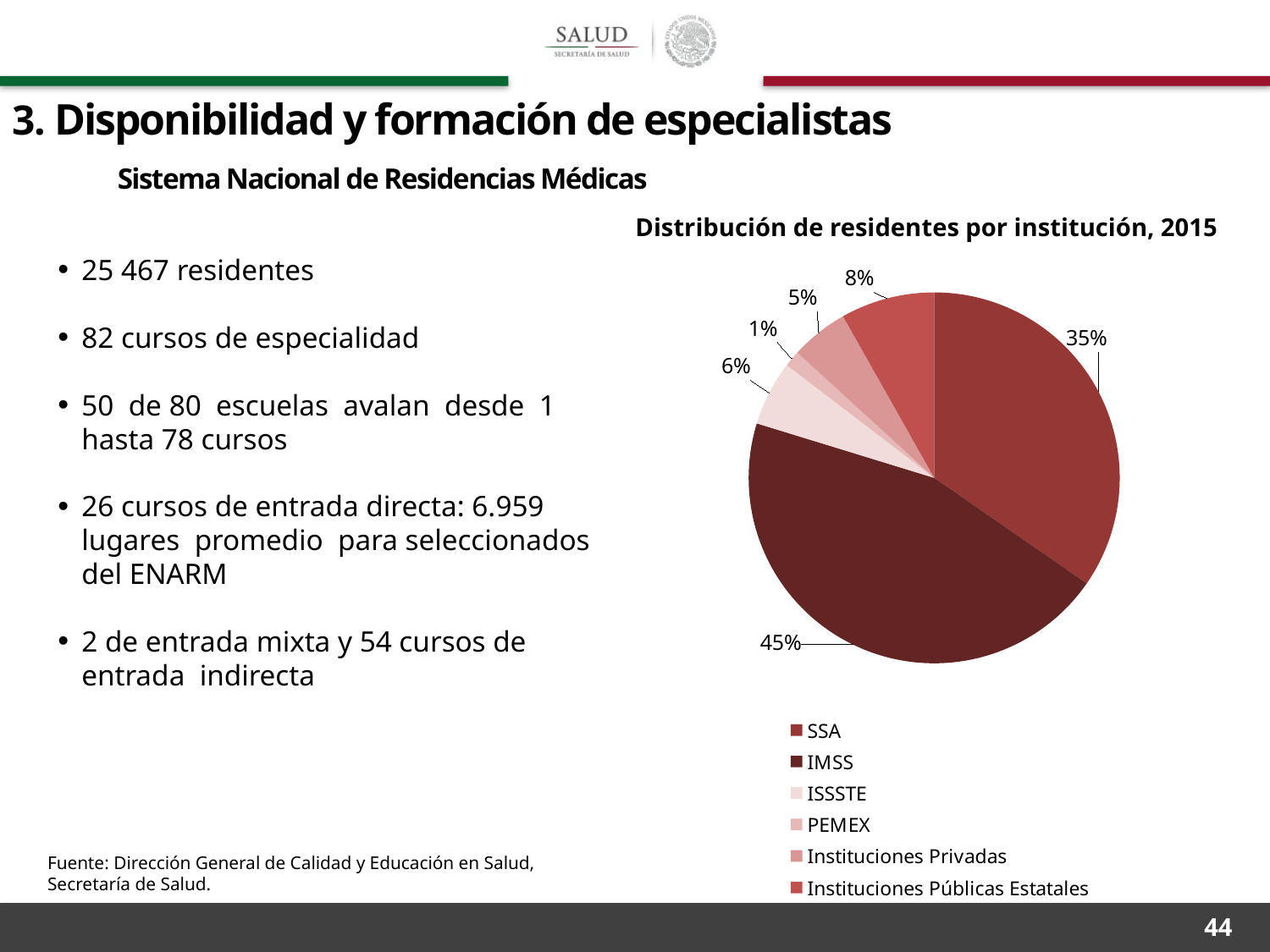
Which has a larger share of residents, ISSSTE or Instituciones Privadas? ISSSTE What percentage of residents is shown for ISSSTE? 6% Which institution has the largest share of residents in the pie chart? IMSS Which institution has the smallest share of residents? PEMEX What percentage of residents is shown for PEMEX? 1% How many institutions are listed in the chart legend? 6 What share of residents does SSA account for? 35% What type of chart is used to show the distribution of residents by institution? Pie chart What share of residents does IMSS account for in the pie chart? 45% What is the title of the chart on the slide? Distribución de residentes por institución, 2015 What share of residents is attributed to Instituciones Públicas Estatales? 8% What is the difference in percentage points between the IMSS share and the SSA share? 10 percentage points